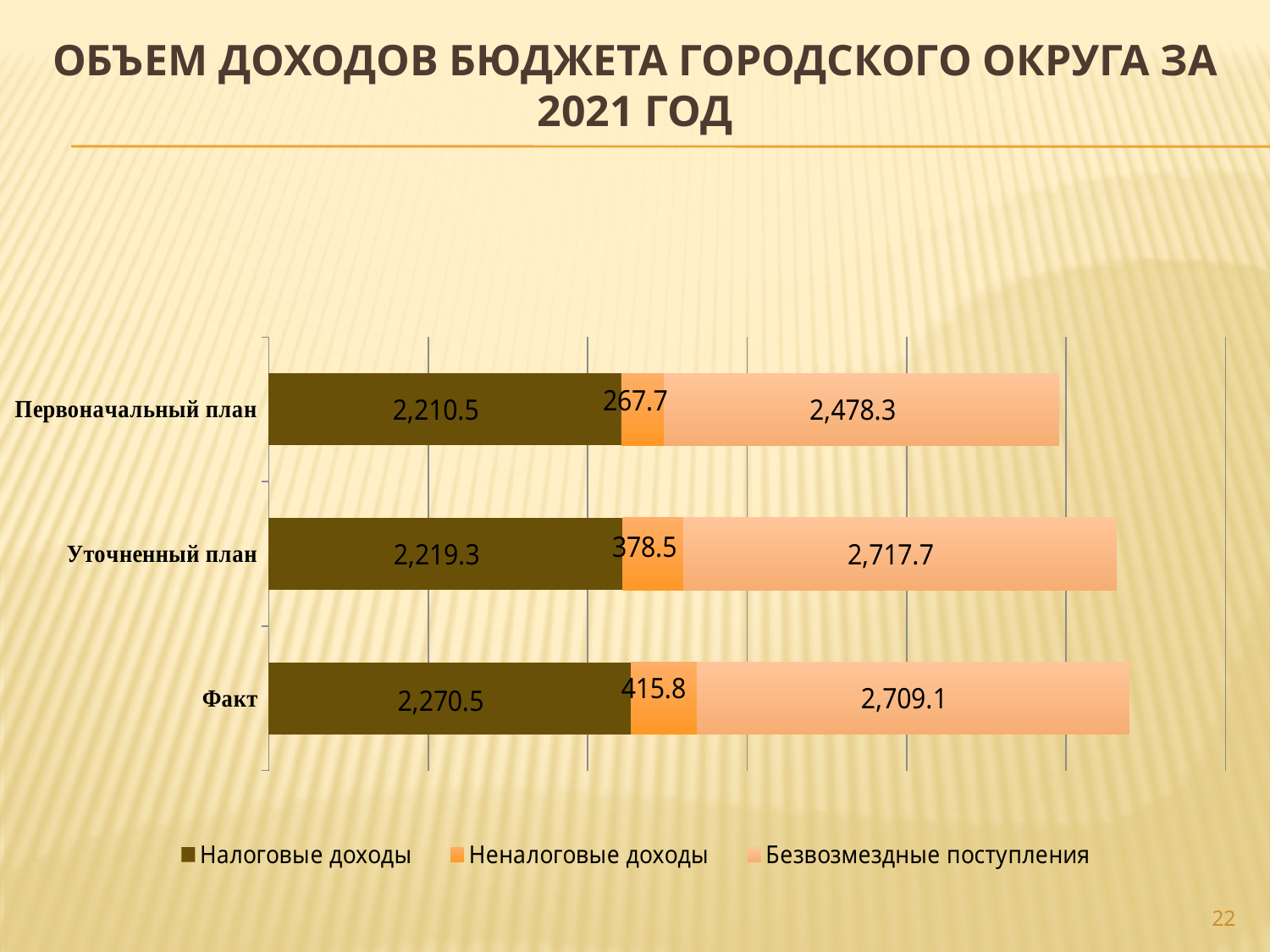
What is the value of Неналоговые доходы for Первоначальный план? 267.7 What is the value of Безвозмездные поступления for Уточненный план? 2,717.7 What is the total of the stacked bar for Первоначальный план? 4,956.5 What is the difference between Неналоговые доходы for Факт and for Уточненный план? 37.3 How many series does the legend list? 3 How many categories are shown on the chart? 3 What is the value of Налоговые доходы for Факт? 2,270.5 What is the total of the stacked bar for Факт? 5,395.4 Which category has the highest value of Неналоговые доходы? Факт What is the difference between Налоговые доходы for Факт and for Первоначальный план? 60.0 Which is larger: Безвозмездные поступления for Уточненный план or for Факт? Уточненный план Which category has the lowest value of Безвозмездные поступления? Первоначальный план